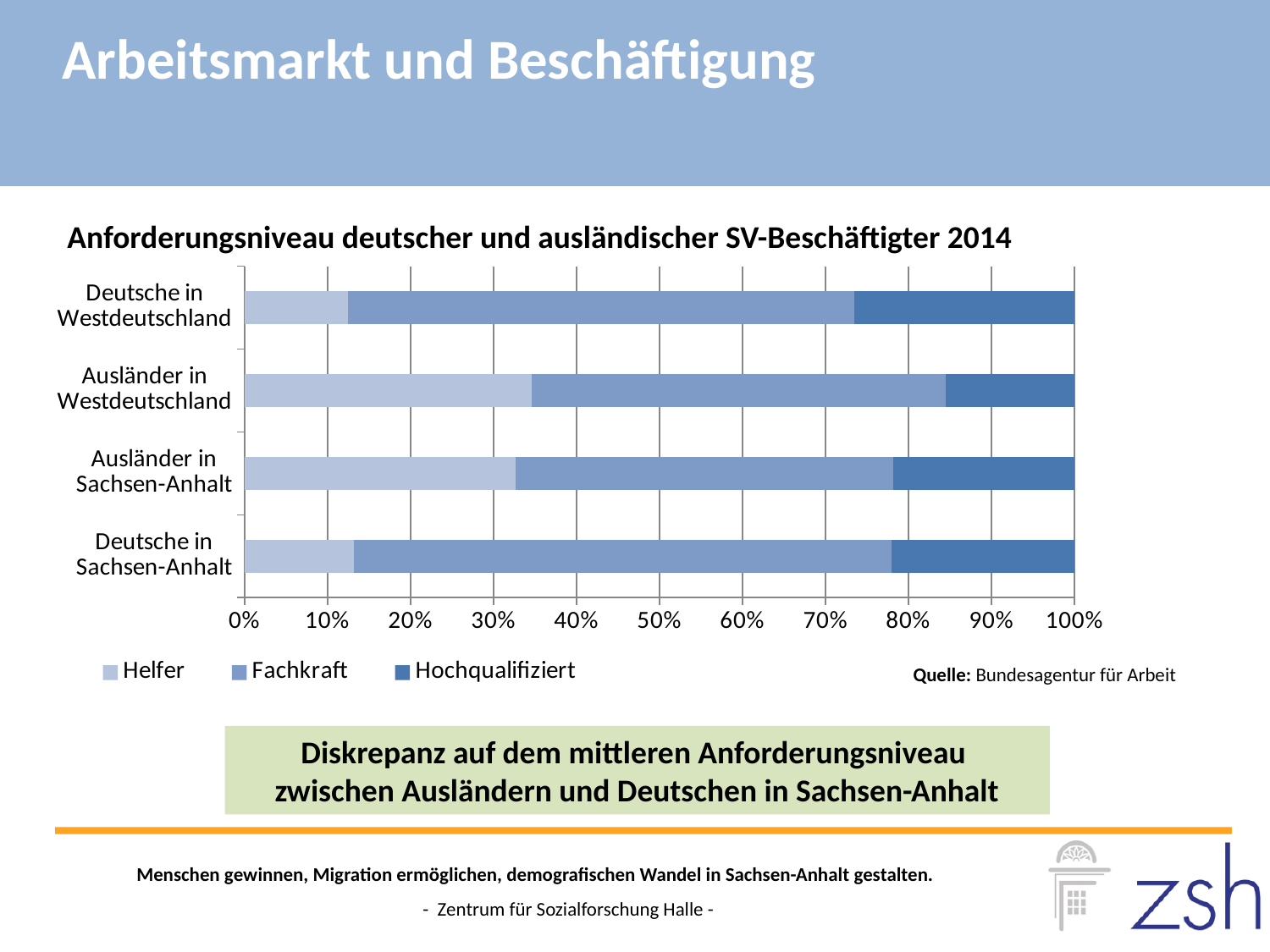
What is the total of each stacked bar in the chart? 100% Which group has the smallest Hochqualifiziert share? Ausländer in Westdeutschland How many groups (categories) are shown on the y axis of the chart? 4 Which has the larger Helfer share: Ausländer in Sachsen-Anhalt or Deutsche in Sachsen-Anhalt? Ausländer in Sachsen-Anhalt Which group has the largest Hochqualifiziert share? Deutsche in Westdeutschland Is the Helfer share for Deutsche in Westdeutschland greater or less than 20%? less What kind of chart is shown on the slide? Stacked bar chart What is the title of the chart? Anforderungsniveau deutscher und ausländischer SV-Beschäftigter 2014 What are the three series named in the legend? Helfer, Fachkraft, Hochqualifiziert How many series does the chart legend list? 3 Is the Helfer share for Ausländer in Westdeutschland greater or less than 30%? greater Is the Hochqualifiziert share for Ausländer in Westdeutschland greater or less than 20%? less